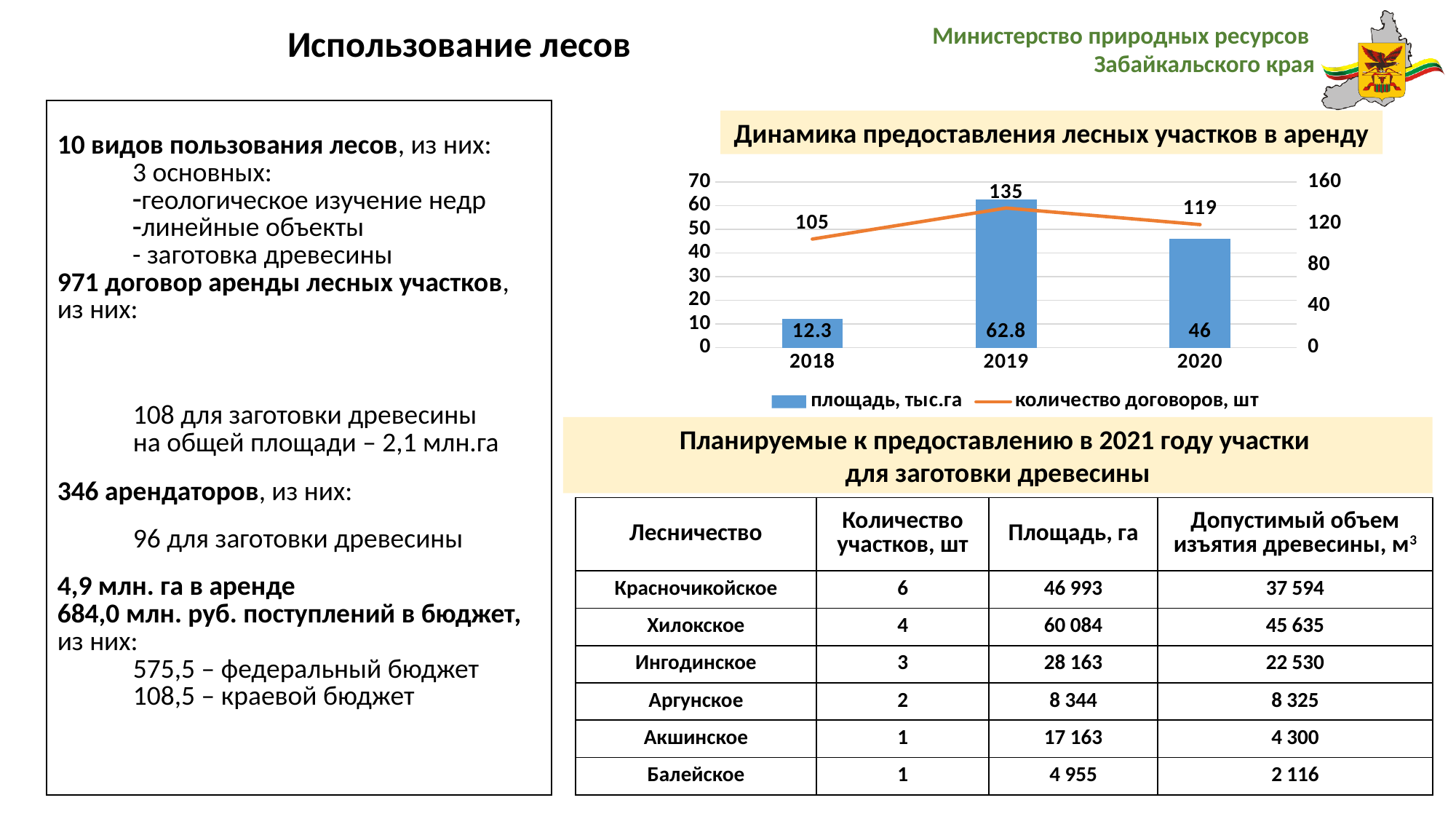
What is the value of площадь, тыс.га for 2019? 62.8 What is the value of площадь, тыс.га for 2018? 12.3 Which year has the highest value of площадь, тыс.га? 2019 How many series does the chart legend list? 2 Which is larger: площадь, тыс.га in 2020 or in 2018? 2020 What is the difference between количество договоров, шт in 2019 and 2018? 30 What is the title of the chart? Динамика предоставления лесных участков в аренду Which year has the lowest value of количество договоров, шт? 2018 How many years are shown on the x axis of the chart? 3 What is the value of количество договоров, шт for 2018? 105 What is the difference between площадь, тыс.га in 2019 and 2020? 16.8 What is the value of количество договоров, шт for 2020? 119